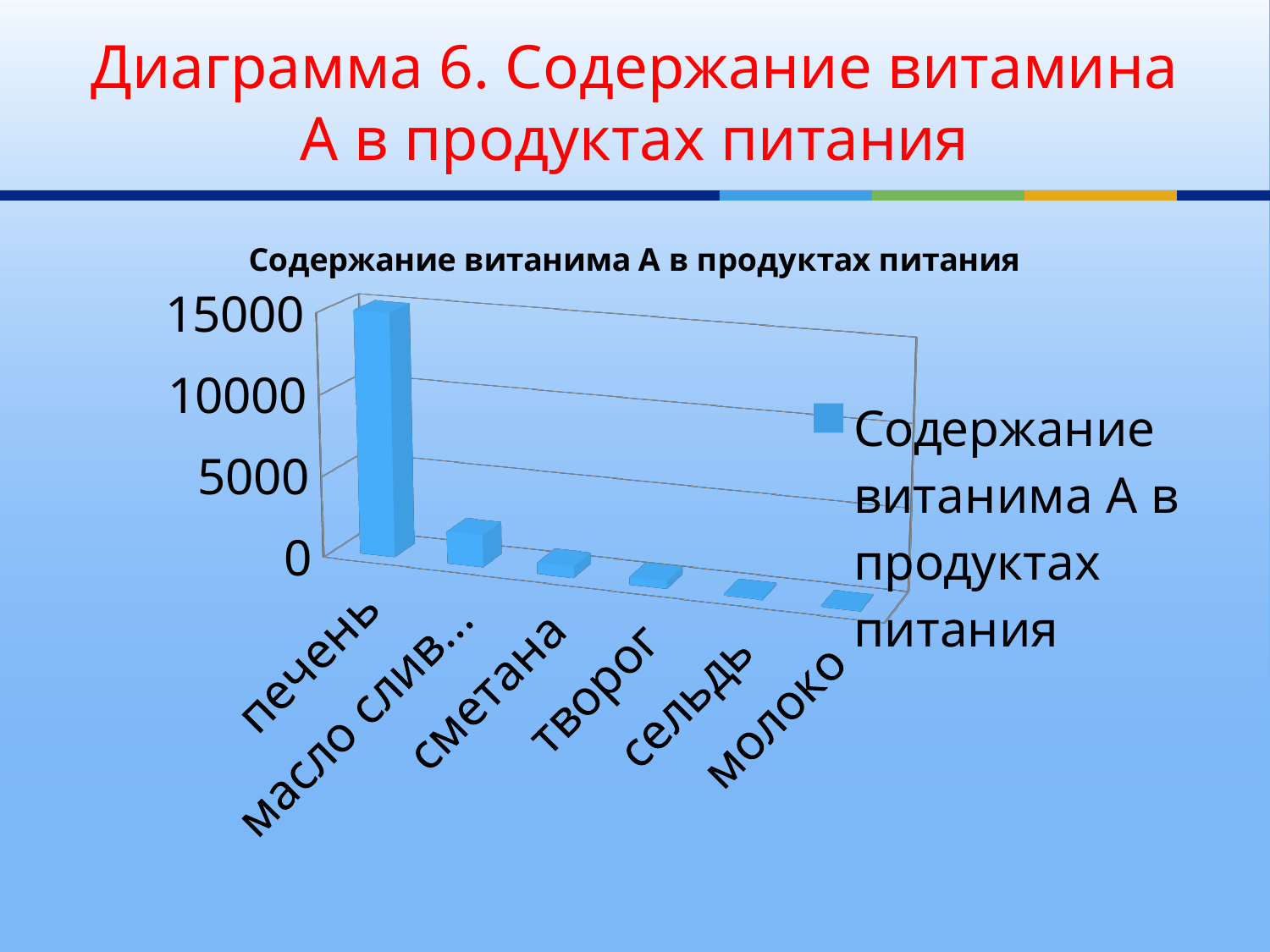
Which product has the highest vitamin A content in the chart? печень Is the value for печень greater or less than 10000? greater Is the value for сметана greater or less than 5000? less Which has a larger value, печень or масло слив...? печень Is the value for молоко greater or less than 5000? less How many series does the chart legend list? 1 What is the title of the chart? Содержание витанима А в продуктах питания Do the values rise or fall moving from left to right along the x axis? fall Which has a larger value, масло слив... or сметана? масло слив... How many product categories are shown on the x axis of the chart? 6 What kind of chart is shown on the slide? bar chart